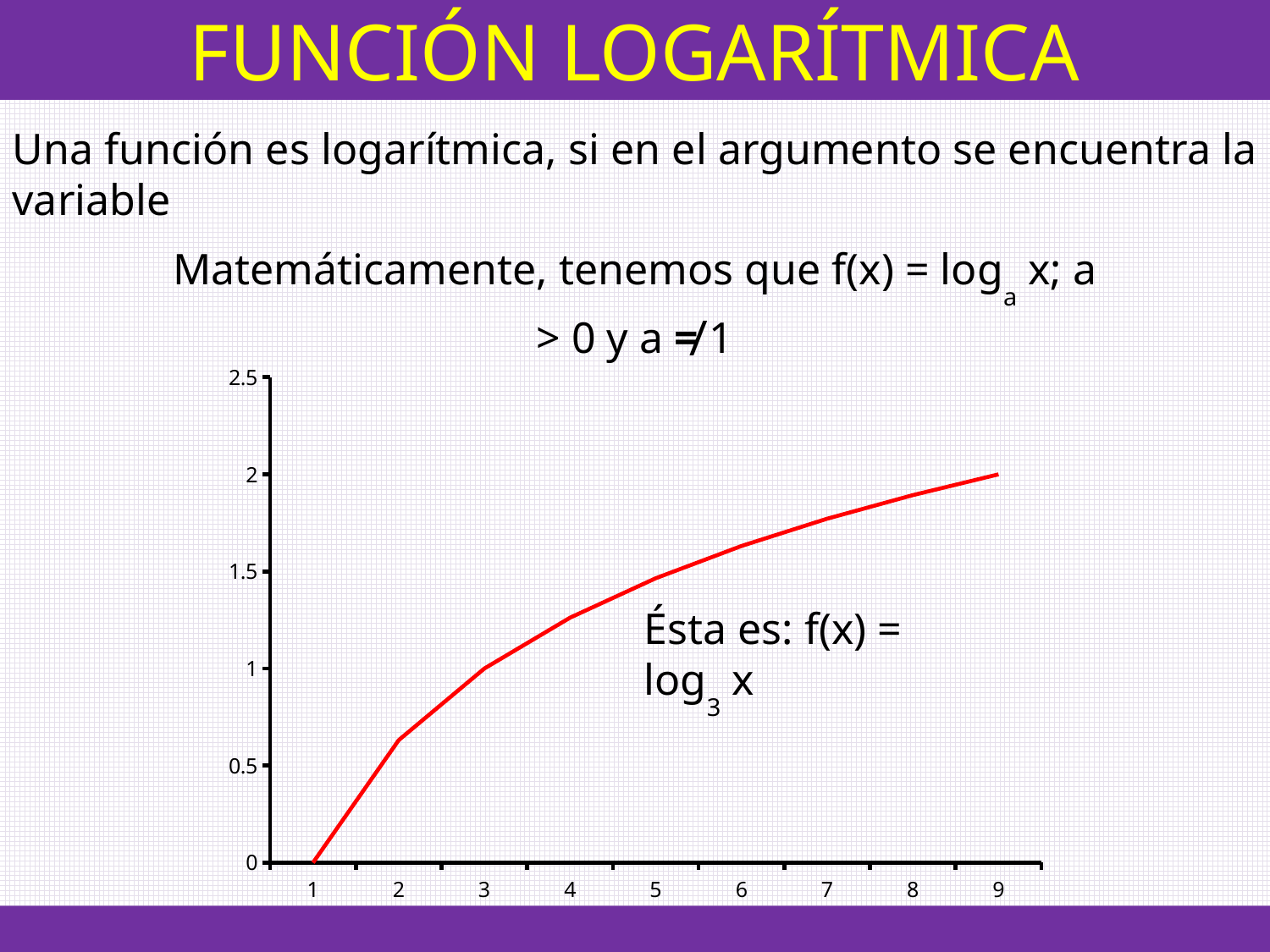
What is the difference between the function values at x = 9 and x = 3? 1 Is the value of the plotted function at x = 2 greater or less than 0.5? greater Is the value of the plotted function at x = 7 greater or less than 2? less What function does the chart plot, according to the label next to the curve? f(x) = log3 x What kind of chart is shown on the slide? line chart At which labelled x value does the curve reach its highest value? 9 What is the value of the plotted function at x = 1? 0 What is the value of the plotted function at x = 3? 1 Do the plotted values rise or fall as x increases from 1 to 9? rise At which labelled x value does the curve have its lowest value? 1 What is the value of the plotted function at x = 9? 2